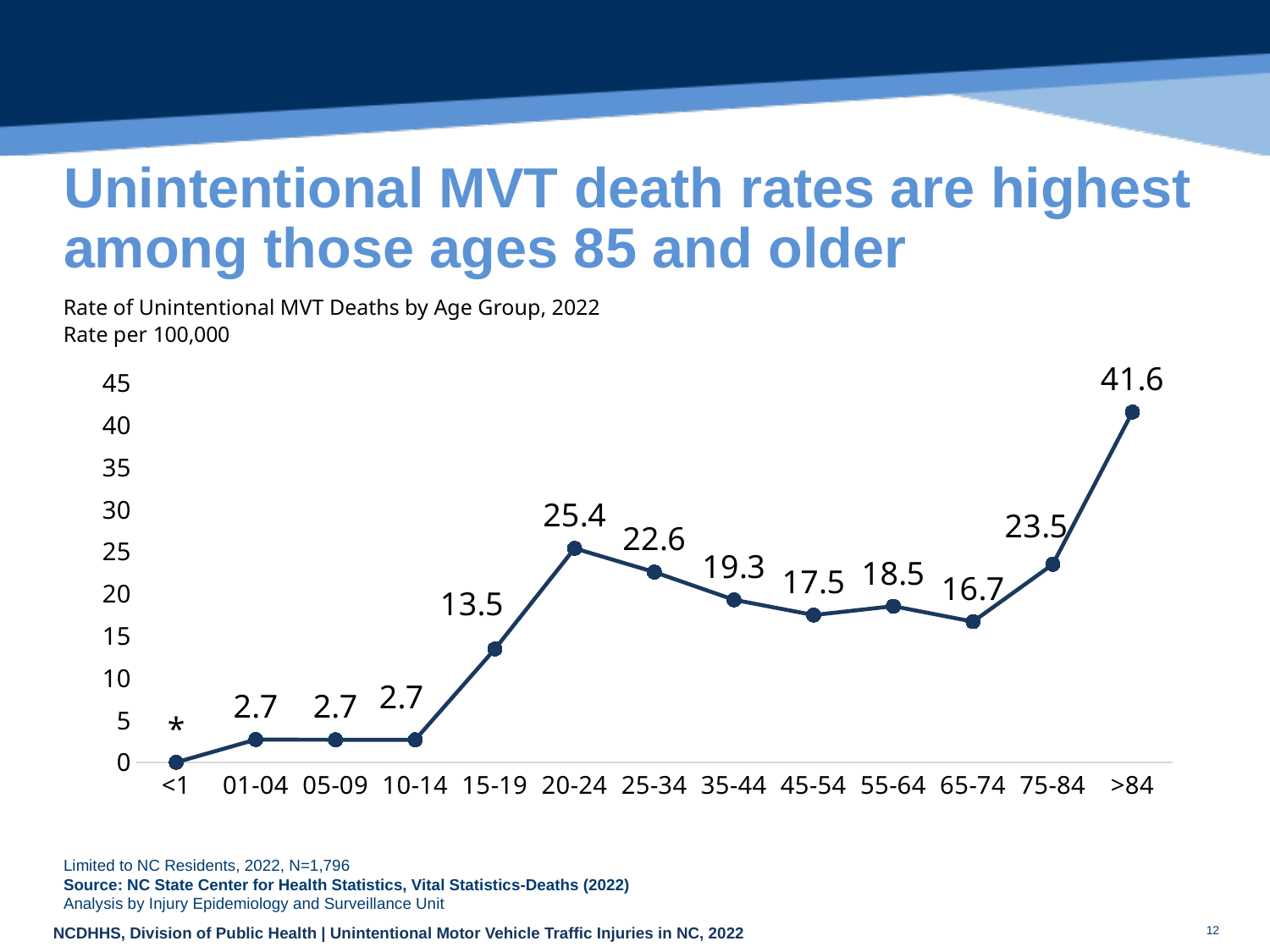
What is the rate of unintentional MVT deaths for the 65-74 age group? 16.7 What is the difference between the rates for the >84 and 75-84 age groups? 18.1 What is the rate of unintentional MVT deaths for the 20-24 age group? 25.4 Which age group has a higher rate, 45-54 or 55-64? 55-64 What is the difference between the rates for the 20-24 and 15-19 age groups? 11.9 How many age groups are shown on the x axis? 13 What is the rate of unintentional MVT deaths for the >84 age group? 41.6 What label is shown for the <1 age group instead of a value? * Which age group has the highest rate of unintentional MVT deaths? >84 Is the rate for the 25-34 age group greater or less than 20? greater Among the age groups with a printed value, which has the lowest rate of unintentional MVT deaths? 01-04, 05-09 and 10-14 (all 2.7) What kind of chart is shown on the slide? Line chart